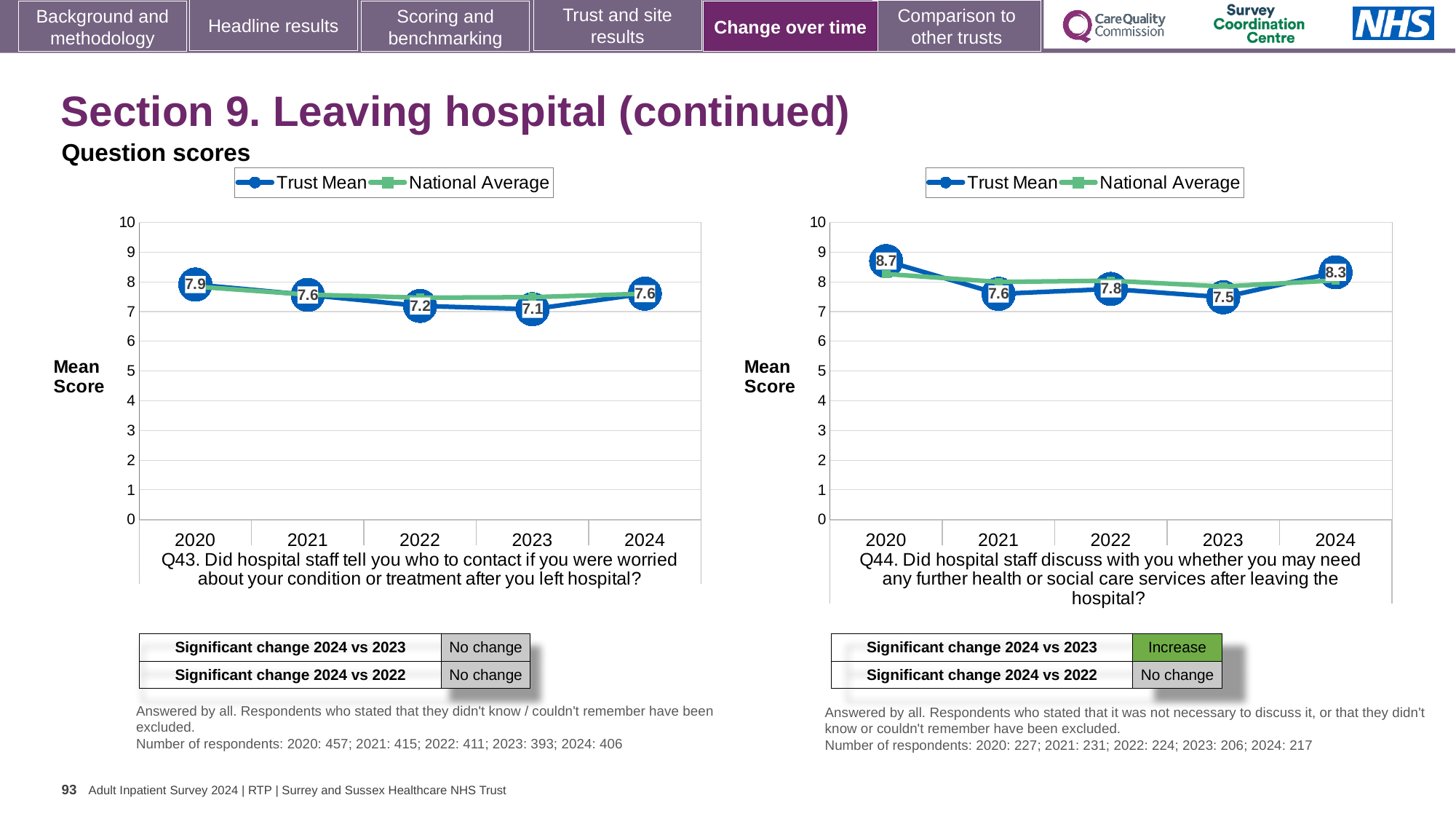
In the Q43 chart on the left, what is the difference between the Trust Mean scores for 2020 and 2023? 0.8 In the Q44 chart on the right, which year has the highest Trust Mean score? 2020 How many years are plotted on the x axis of the Q43 chart on the left? 5 In the Q44 chart on the right, which year has the lowest Trust Mean score? 2023 In the Q43 chart on the left, what is the Trust Mean score for 2020? 7.9 In the Q44 chart on the right, is the Trust Mean score for 2022 larger than the score for 2023? Yes, 2022 (7.8) is larger than 2023 (7.5) In the Q44 chart on the right, what is the difference between the Trust Mean scores for 2020 and 2021? 1.1 In the Q43 chart on the left, how many series does the legend list? 2 What type of chart is used for the Q44 chart on the right? Line chart In the Q43 chart on the left, which year has the lowest Trust Mean score? 2023 In the Q43 chart on the left, what is the Trust Mean score for 2023? 7.1 In the Q44 chart on the right, what is the Trust Mean score for 2024? 8.3